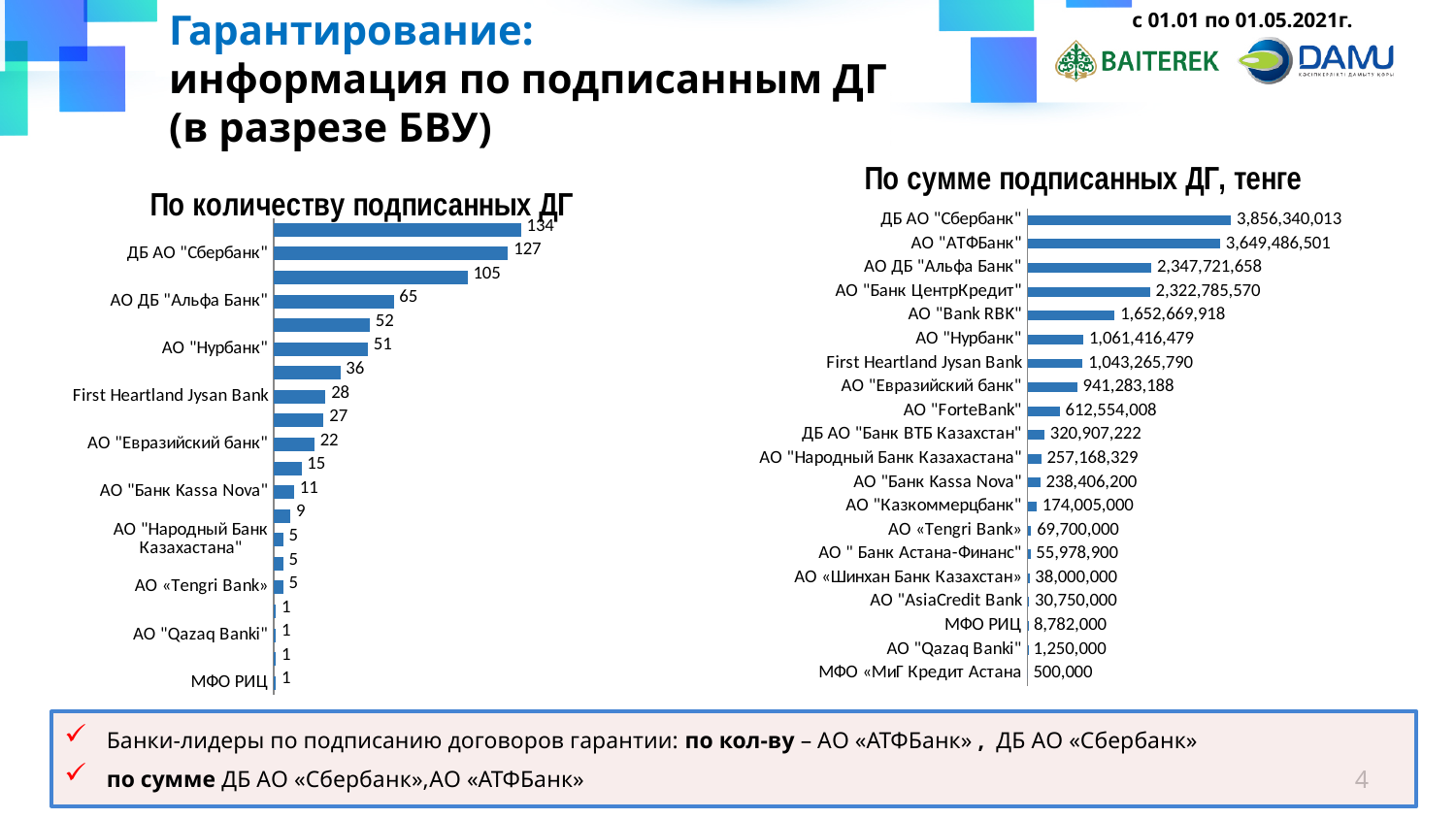
In the chart "По сумме подписанных ДГ, тенге", which category has the lowest value? МФО «МиГ Кредит Астана» In the chart "По количеству подписанных ДГ", what is the value for АО ДБ "Альфа Банк"? 65 What type of chart is the left chart "По количеству подписанных ДГ"? Bar chart How many categories are shown in the chart "По сумме подписанных ДГ, тенге"? 20 In the chart "По сумме подписанных ДГ, тенге", which is larger: АО "Нурбанк" or First Heartland Jysan Bank? АО "Нурбанк" In the chart "По сумме подписанных ДГ, тенге", what is the value for АО "Bank RBK"? 1,652,669,918 In the chart "По количеству подписанных ДГ", what is the value for АО "Нурбанк"? 51 In the chart "По сумме подписанных ДГ, тенге", which bank has the highest value? ДБ АО "Сбербанк" In the chart "По количеству подписанных ДГ", what is the difference between ДБ АО "Сбербанк" and АО ДБ "Альфа Банк"? 62 In the chart "По количеству подписанных ДГ", what is the value for First Heartland Jysan Bank? 28 In the chart "По сумме подписанных ДГ, тенге", what is the difference between ДБ АО "Сбербанк" and АО "АТФБанк"? 206,853,512 In the chart "По сумме подписанных ДГ, тенге", what is the value for АО "ForteBank"? 612,554,008